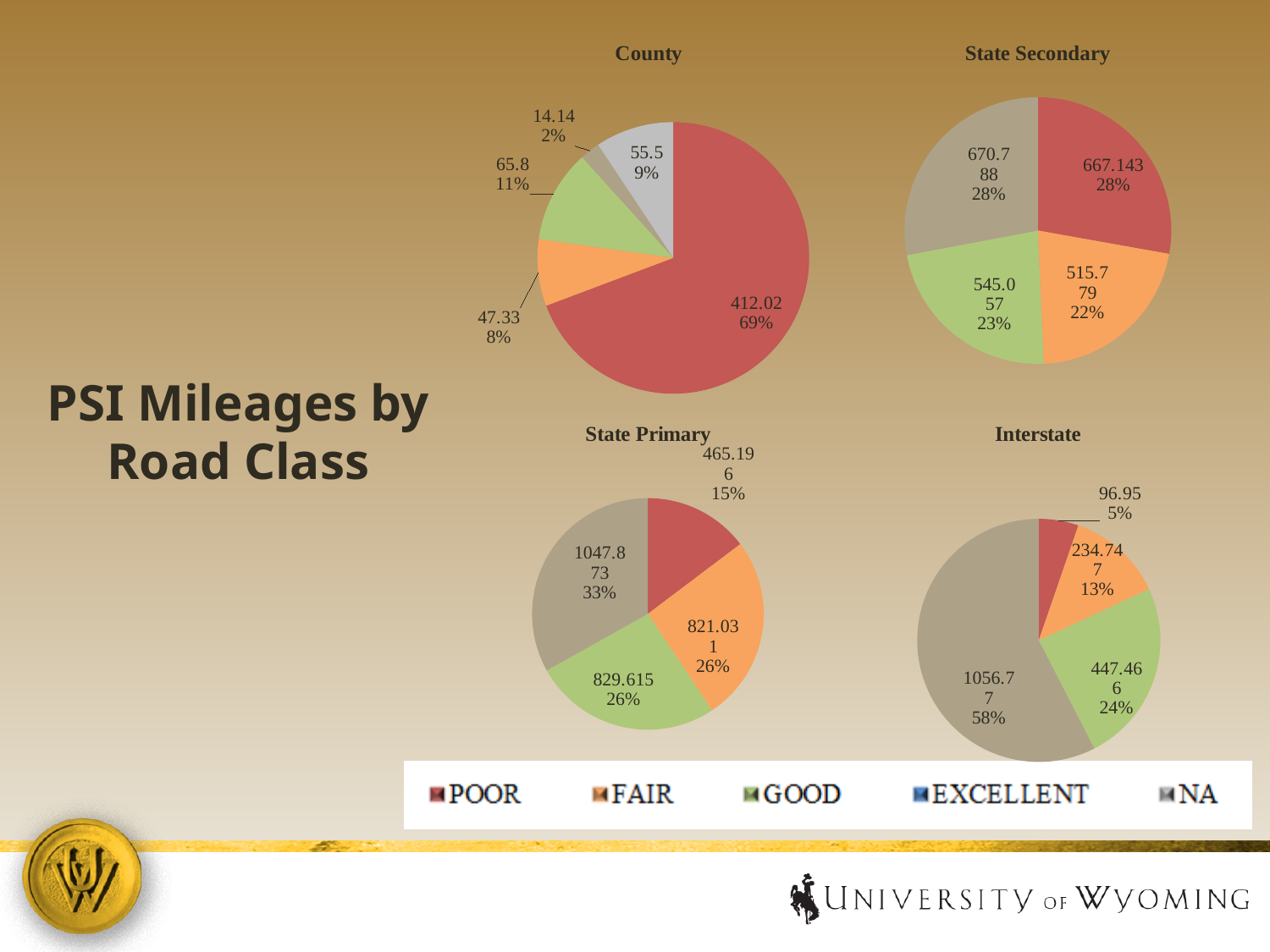
How many entries does the shared legend list? 5 In the County chart, which slice is larger, the green GOOD slice or the orange FAIR slice? GOOD In the County chart, what is the value of the slice labelled 69%? 412.02 In the State Primary chart, what is the largest share shown? 33% In the Interstate chart, what is the value of the slice labelled 5%? 96.95 In the Interstate chart, what is the smallest share shown? 5% In the County chart, what share of the pie does the 55.5 slice represent? 9% In the County chart, what is the difference in percentage points between the 69% slice and the 11% slice? 58% In the State Primary chart, what share of the pie does the 829.615 slice represent? 26% How many pie charts are shown on the slide? 4 Which chart is positioned at the top right of the slide? State Secondary What kind of chart is the County chart? pie chart